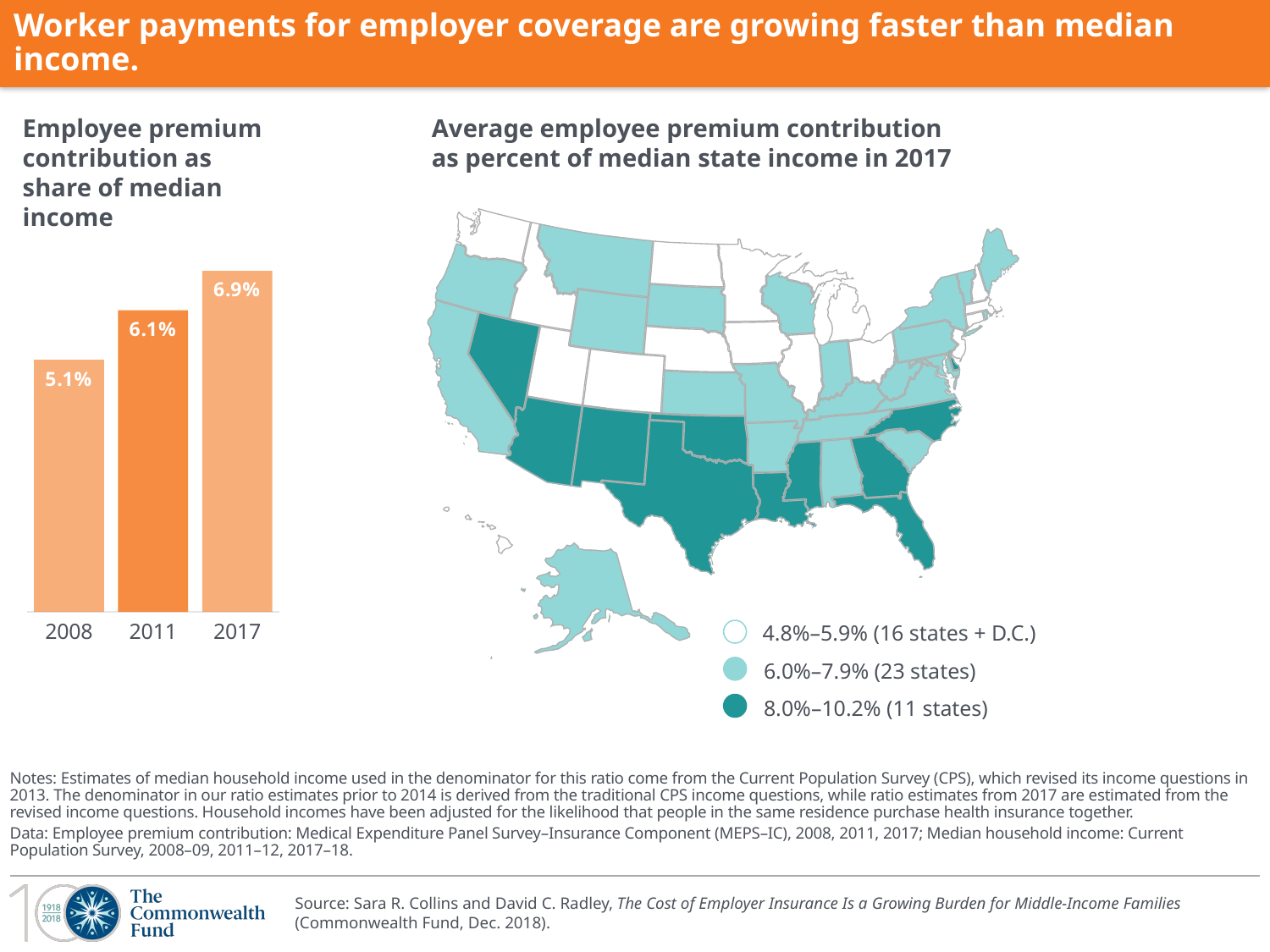
In the bar chart 'Employee premium contribution as share of median income', what is the value for 2017? 6.9% In the bar chart on the left, which year has the lowest employee premium contribution as a share of median income? 2008 In the bar chart 'Employee premium contribution as share of median income', what is the value for 2011? 6.1% In the bar chart on the left, do the values rise or fall from 2008 to 2017? Rise In the bar chart on the left, which is larger, the value for 2011 or the value for 2017? 2017 In the bar chart on the left, what is the difference between the 2017 value and the 2008 value? 1.8 percentage points In the bar chart on the left, which year has the highest employee premium contribution as a share of median income? 2017 What kind of chart is 'Employee premium contribution as share of median income'? Bar chart How many bars are shown in the bar chart 'Employee premium contribution as share of median income'? 3 In the bar chart 'Employee premium contribution as share of median income', what is the value for 2008? 5.1% In the map 'Average employee premium contribution as percent of median state income in 2017', how many states fall in the 8.0%–10.2% category according to the legend? 11 states In the bar chart on the left, what is the difference between the 2011 value and the 2008 value? 1.0 percentage point